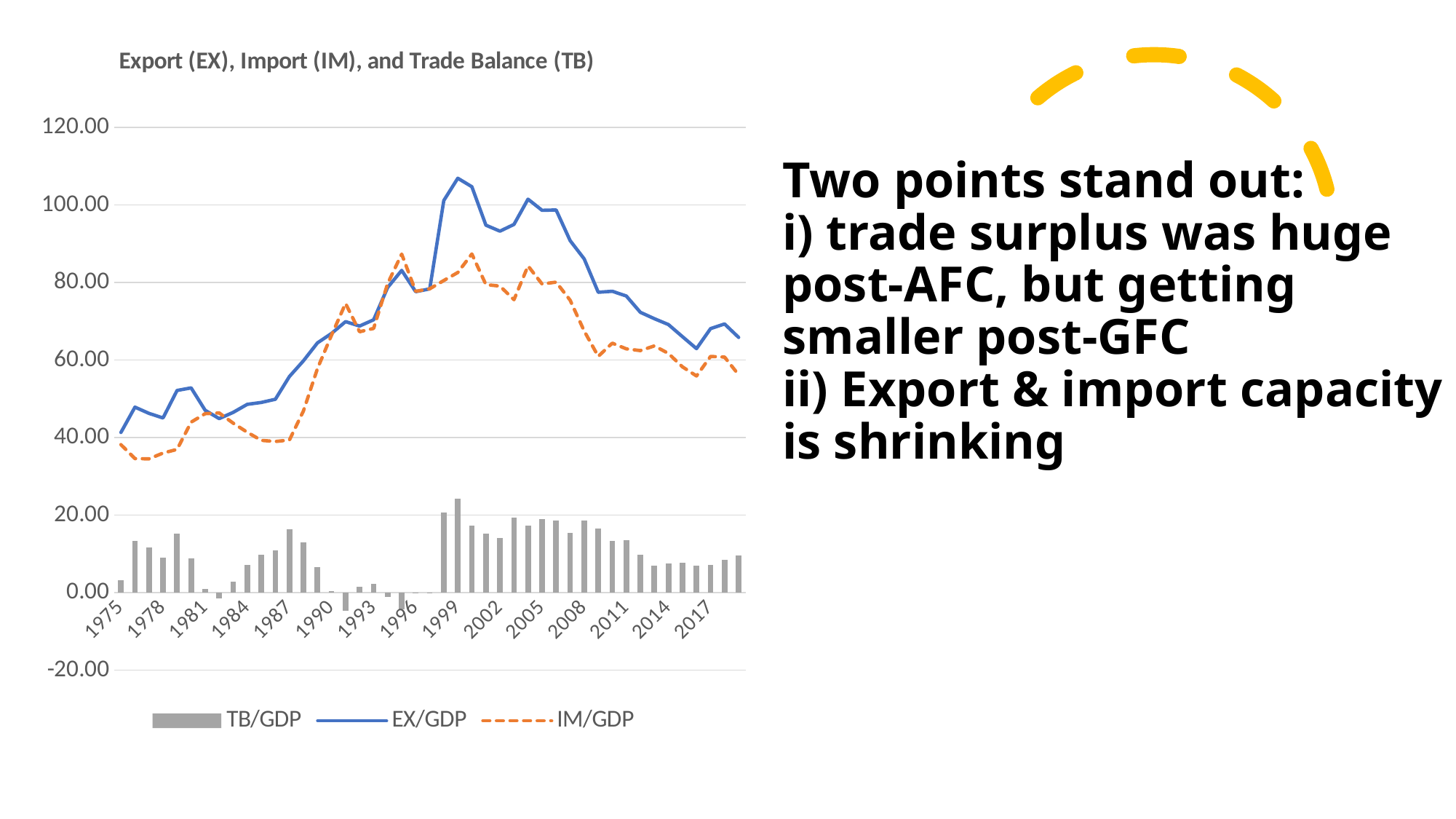
Which series in the chart is plotted as bars rather than a line? TB/GDP Does EX/GDP rise or fall between 2005 and 2017? fall Is the value of TB/GDP in 2017 greater or less than 20? less Does IM/GDP rise or fall between 1987 and 1996? rise In 2005, which is larger, EX/GDP or IM/GDP? EX/GDP Is the value of EX/GDP in 2005 greater or less than 80? greater How many series does the chart legend list? 3 What is the title of the chart? Export (EX), Import (IM), and Trade Balance (TB) Is the value of IM/GDP in 2017 greater or less than 80? less In 2011, which is larger, EX/GDP or IM/GDP? EX/GDP What kind of chart is this? A combined bar and line chart